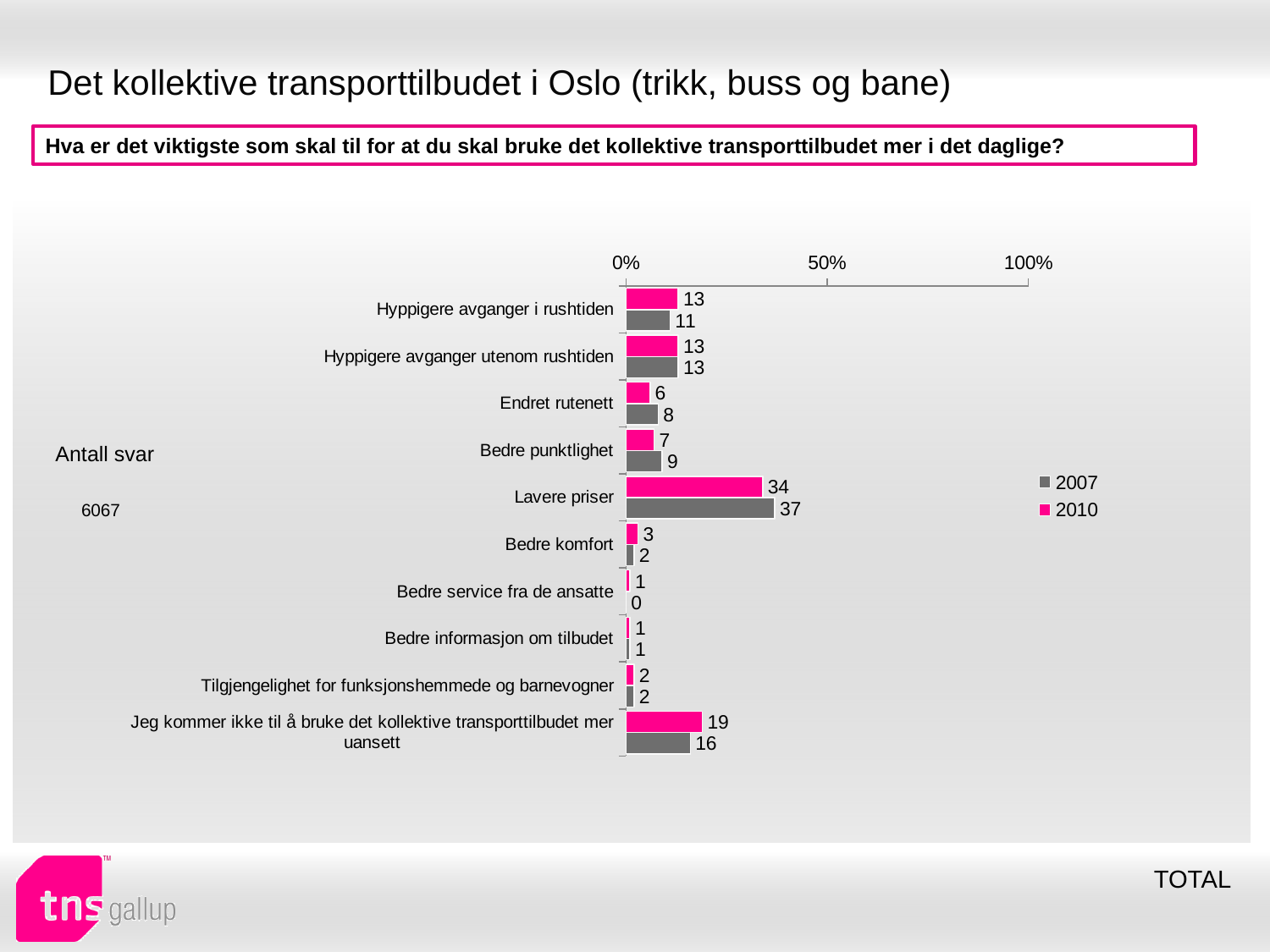
What is the 2007 value for Hyppigere avganger i rushtiden? 11 What is the 2007 value for Jeg kommer ikke til å bruke det kollektive transporttilbudet mer uansett? 16 Which category has the lowest 2007 value? Bedre service fra de ansatte What is the difference between the 2007 and 2010 values for Lavere priser? 3 How many series does the legend list? 2 What kind of chart is shown on the slide? bar chart Which colour represents the 2010 series in the legend? pink Which is larger for Bedre punktlighet, the 2007 value or the 2010 value? 2007 Which category has the highest 2007 value? Lavere priser How many categories are shown on the chart? 10 What is the 2010 value for Lavere priser? 34 Is the 2007 value for Lavere priser greater or less than 50%? less